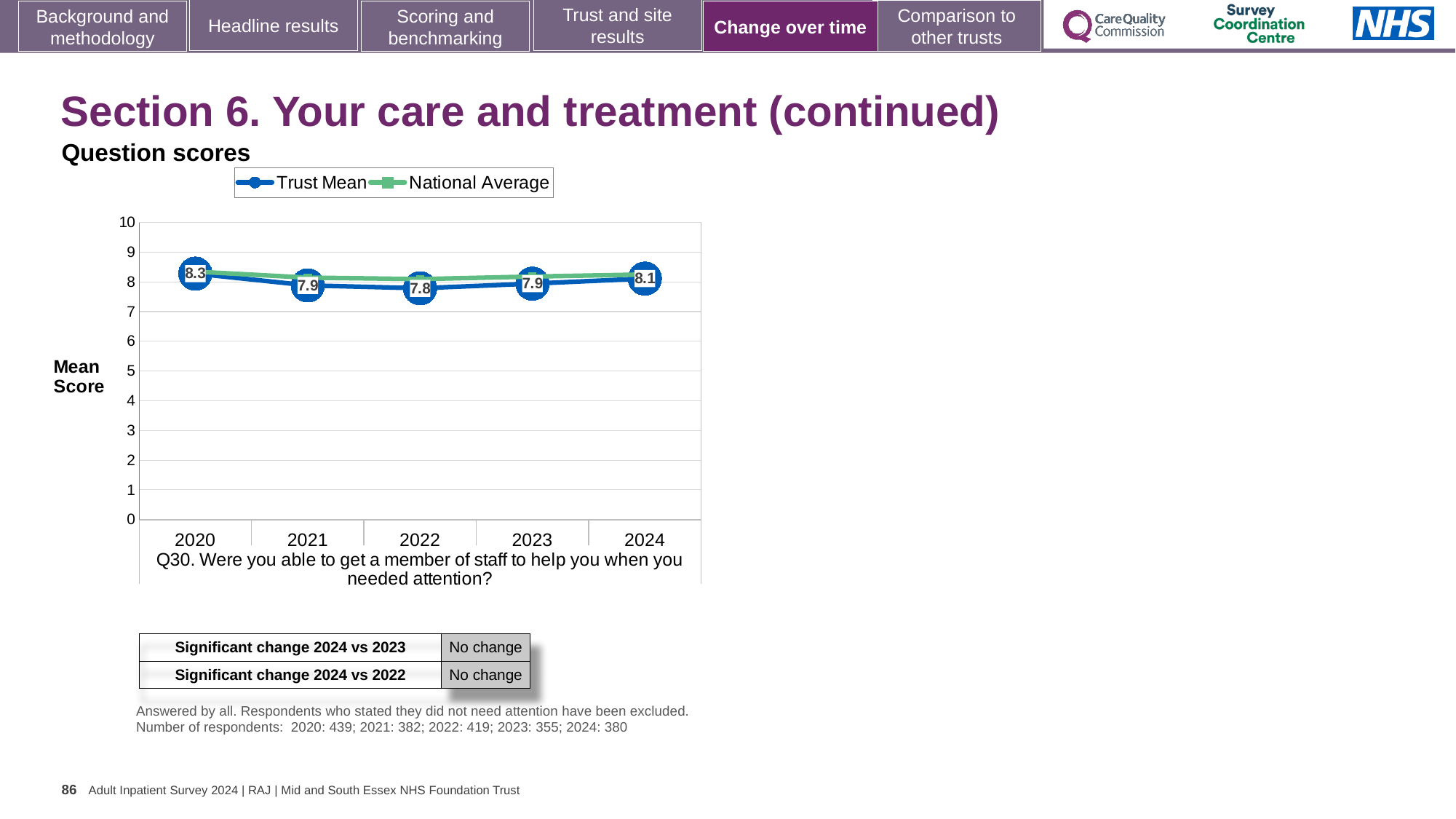
How many series does the legend list? 2 In which year is the Trust Mean score lowest? 2022 How many years are plotted on the x axis? 5 What is the Trust Mean score for 2022? 7.8 Which question does the chart show scores for? Q30. Were you able to get a member of staff to help you when you needed attention? In which year is the Trust Mean score highest? 2020 What is the Trust Mean score for 2024? 8.1 What is the difference between the Trust Mean score in 2020 and in 2022? 0.5 Is the National Average value for 2022 greater or less than 7? greater What is the Trust Mean score for 2020? 8.3 Which is larger, the Trust Mean score in 2024 or in 2023? 2024 What kind of chart is shown? Line chart